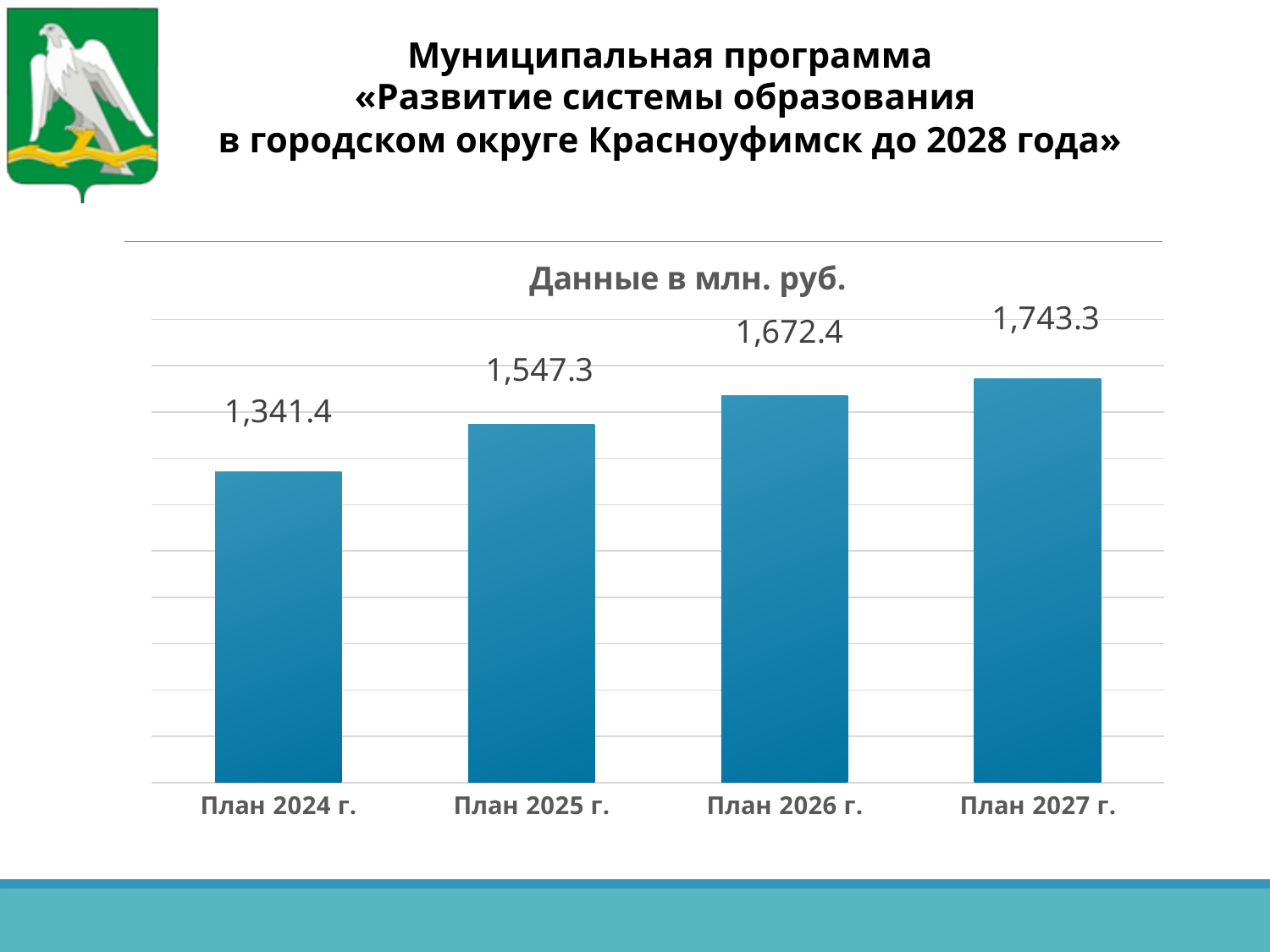
What is the value for План 2027 г.? 1,743.3 Which is larger, the value for План 2025 г. or the value for План 2026 г.? План 2026 г. What is the difference between the values for План 2026 г. and План 2025 г.? 125.1 Which category has the lowest value? План 2024 г. What is the difference between the values for План 2027 г. and План 2024 г.? 401.9 What is the value for План 2024 г.? 1,341.4 What is the value for План 2025 г.? 1,547.3 What is the value for План 2026 г.? 1,672.4 How many categories are shown in the chart? 4 Do the values rise or fall from План 2024 г. to План 2027 г.? Rise What kind of chart is shown on the slide? Bar chart Which category has the highest value? План 2027 г.